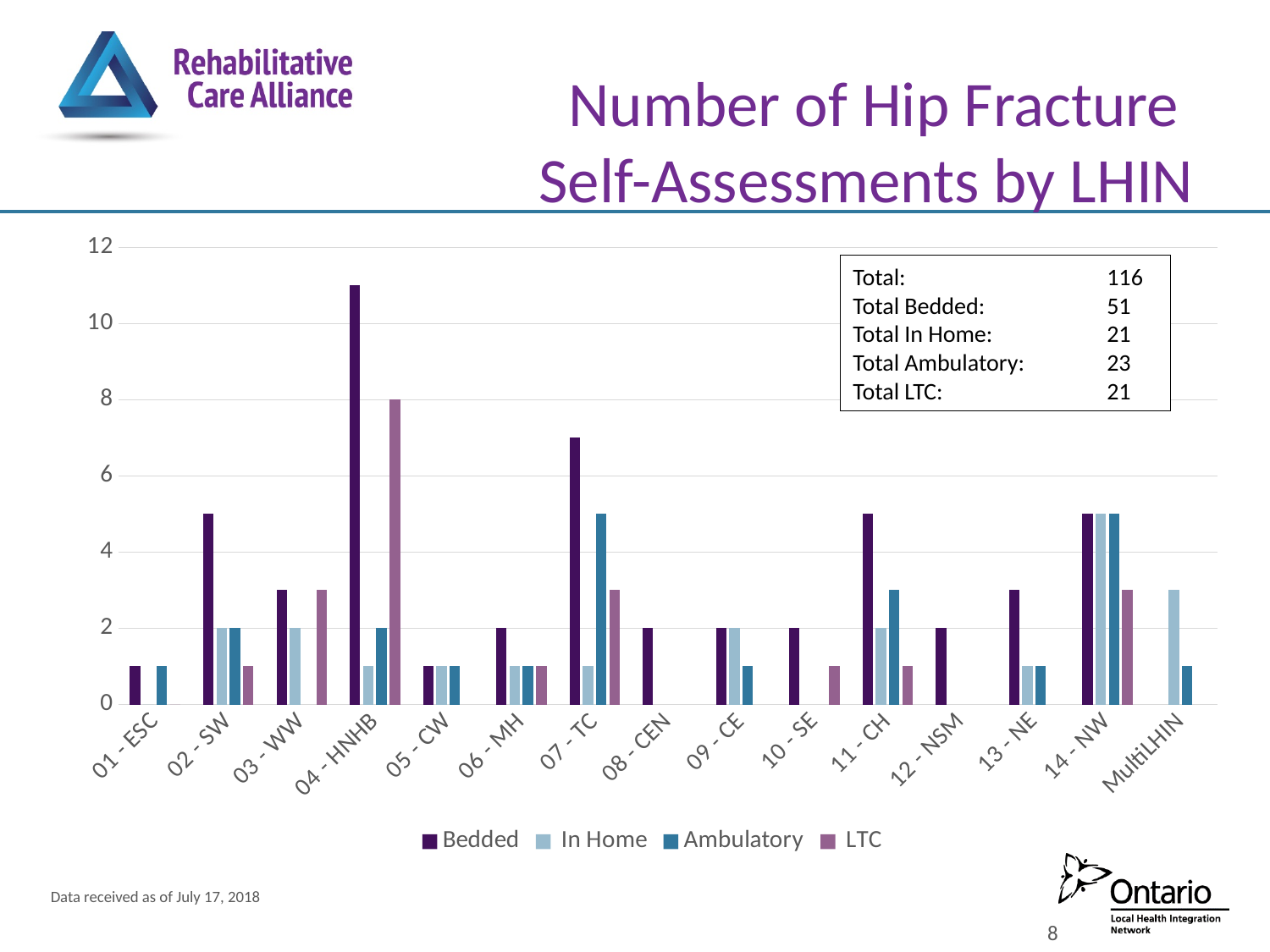
According to the text box on the chart, what is the Total Bedded count? 51 What is the title of the chart? Number of Hip Fracture Self-Assessments by LHIN How many series does the legend list? 4 How many LHIN categories are shown on the x axis? 15 Is the Bedded value for 04 - HNHB greater or less than 10? greater Is the Bedded value for 07 - TC greater or less than 6? greater What is the LTC value for 04 - HNHB? 8 Which LHIN has the highest Bedded value? 04 - HNHB What is the In Home value for 02 - SW? 2 Which is larger for 07 - TC, the Bedded value or the Ambulatory value? Bedded Which LHIN has the highest LTC value? 04 - HNHB What kind of chart is shown on the slide? bar chart